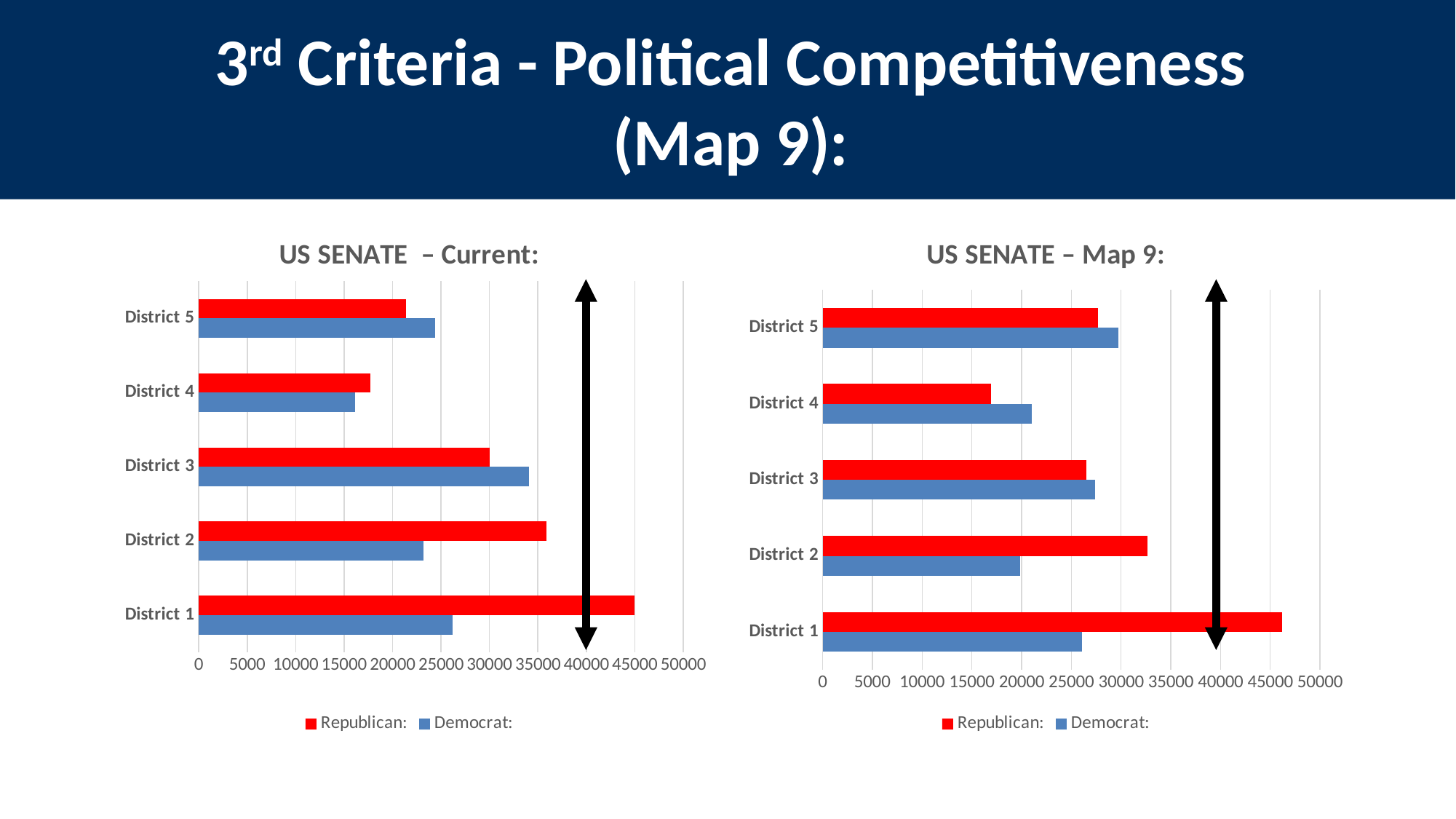
What are the two legend entries on the 'US SENATE – Current' chart? Republican and Democrat In the 'US SENATE – Current' chart, which is larger for District 2, the Republican value or the Democrat value? Republican In the 'US SENATE – Current' chart, is the Republican value for District 1 greater or less than 40000? greater How many series does the legend of the 'US SENATE – Map 9' chart list? 2 In the 'US SENATE – Current' chart, which district has the highest Republican value? District 1 In the 'US SENATE – Map 9' chart, which district has the highest Republican value? District 1 In the 'US SENATE – Map 9' chart, which is larger for District 2, the Republican value or the Democrat value? Republican In the 'US SENATE – Current' chart, which district has the lowest Republican value? District 4 In the 'US SENATE – Map 9' chart, is the Democrat value for District 4 greater or less than 25000? less How many districts are shown on the 'US SENATE – Current' chart? 5 In the 'US SENATE – Map 9' chart, which district has the lowest Republican value? District 4 What kind of chart is the 'US SENATE – Current' chart on the left? bar chart